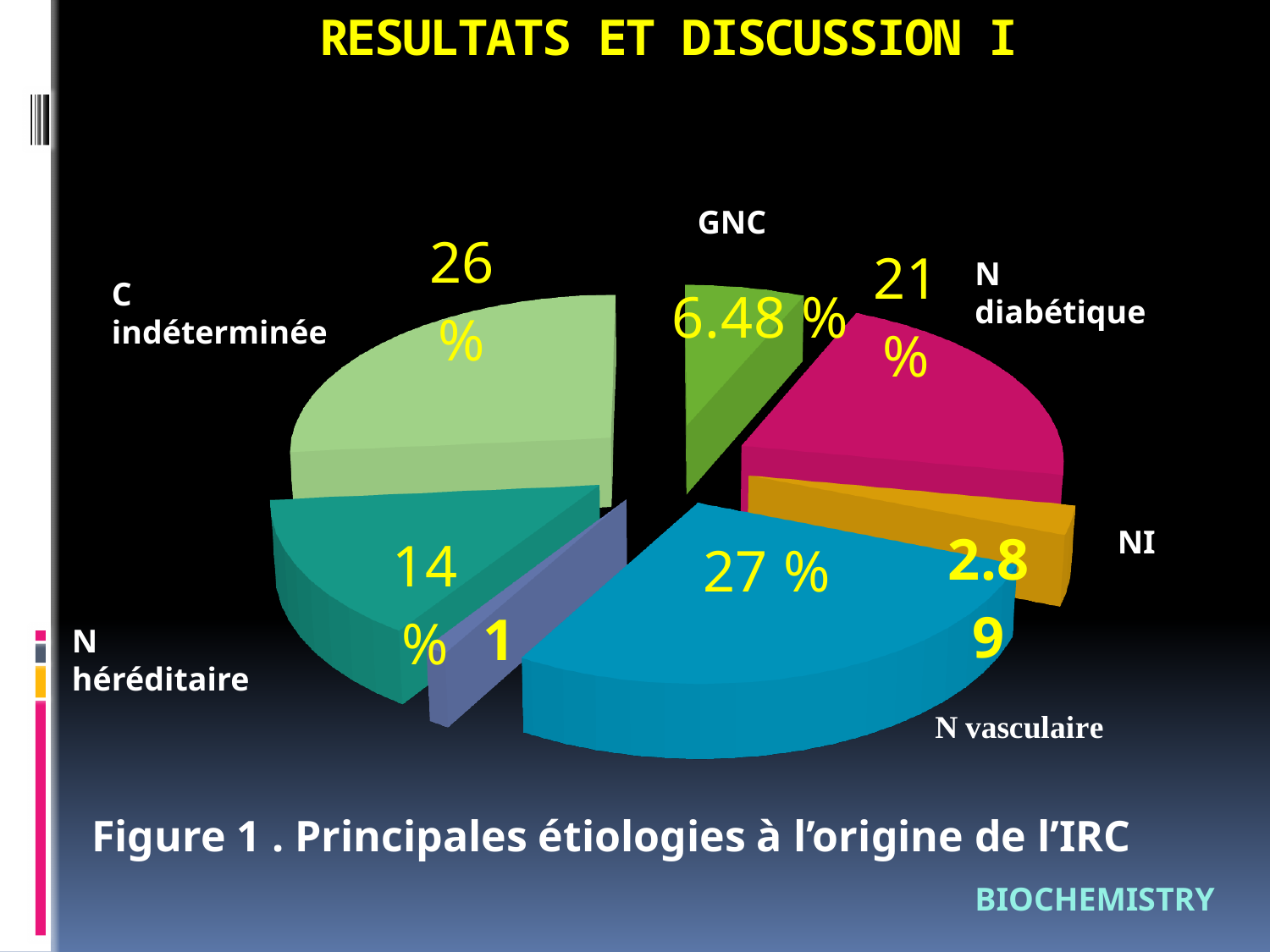
What is the difference in percentage points between N vasculaire and N diabétique? 6 What is the figure caption below the chart? Figure 1 . Principales étiologies à l'origine de l'IRC Which is larger, the share for GNC or the share for N diabétique? N diabétique What type of chart is shown on the slide? pie chart What percentage is shown for C indéterminée? 26 % What percentage is shown for N diabétique? 21 % What percentage is shown for GNC? 6.48 % What percentage is shown for N vasculaire? 27 % Which is larger, the share for N diabétique or the share for C indéterminée? C indéterminée Which category has the largest share of the pie? N vasculaire What is the difference in percentage points between C indéterminée and N diabétique? 5 How many slices does the pie chart have? 7